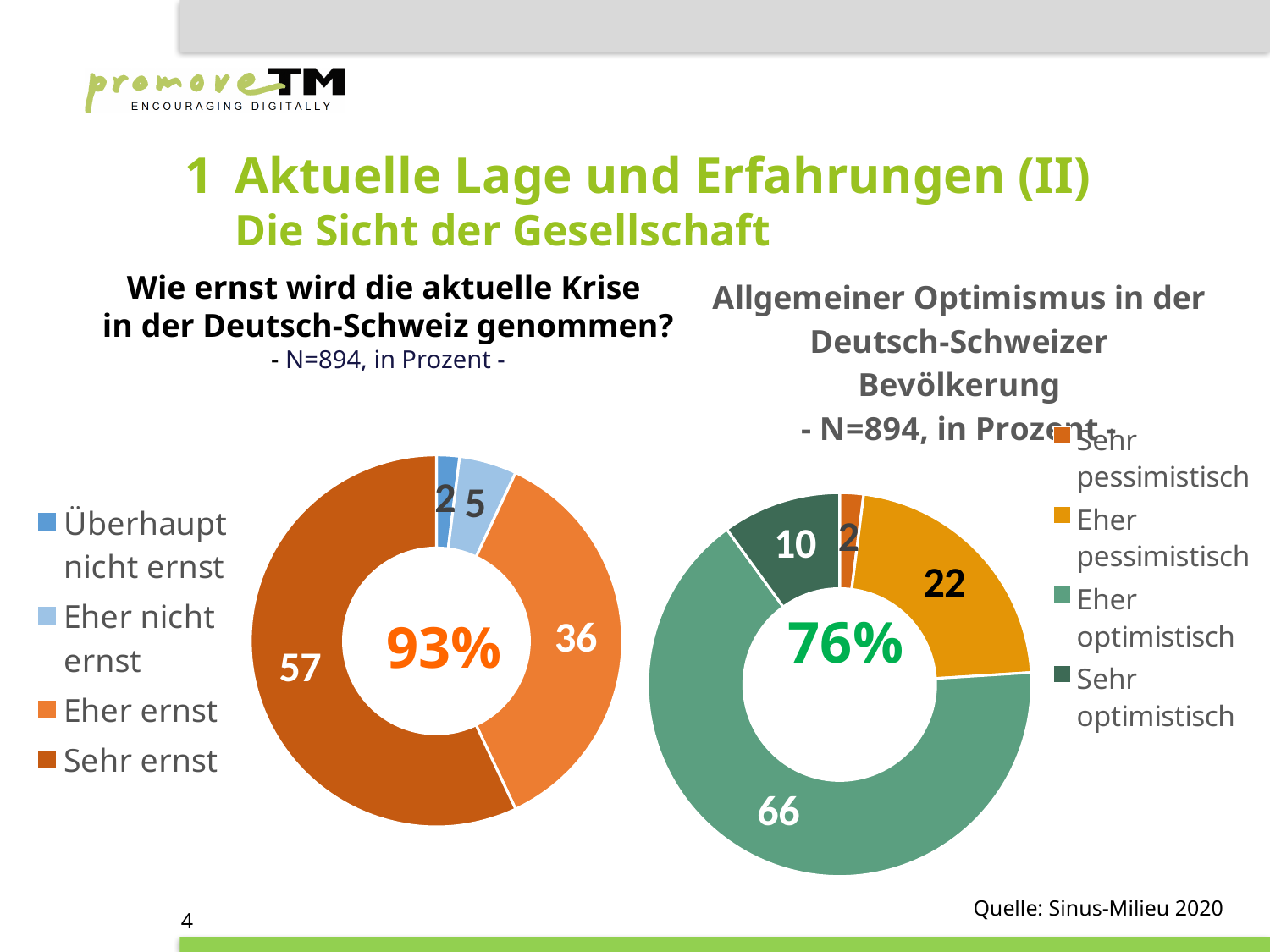
In the left chart (Wie ernst wird die aktuelle Krise in der Deutsch-Schweiz genommen?), what is the difference between Sehr ernst and Eher ernst? 21 In the left chart (Wie ernst wird die aktuelle Krise in der Deutsch-Schweiz genommen?), which category has the smallest value? Überhaupt nicht ernst In the left chart (Wie ernst wird die aktuelle Krise in der Deutsch-Schweiz genommen?), what is the value for Sehr ernst? 57 In the right chart (Allgemeiner Optimismus in der Deutsch-Schweizer Bevölkerung), what is the value for Eher pessimistisch? 22 In the right chart (Allgemeiner Optimismus in der Deutsch-Schweizer Bevölkerung), which is larger: Sehr optimistisch or Eher pessimistisch? Eher pessimistisch In the left chart (Wie ernst wird die aktuelle Krise in der Deutsch-Schweiz genommen?), what is the value for Eher ernst? 36 In the right chart (Allgemeiner Optimismus in der Deutsch-Schweizer Bevölkerung), what is the value for Eher optimistisch? 66 What kind of chart is used for the two charts on the slide? Doughnut (pie) chart In the right chart (Allgemeiner Optimismus in der Deutsch-Schweizer Bevölkerung), what is the difference between Eher optimistisch and Sehr optimistisch? 56 In the right chart (Allgemeiner Optimismus in der Deutsch-Schweizer Bevölkerung), which category has the largest value? Eher optimistisch In the left chart (Wie ernst wird die aktuelle Krise in der Deutsch-Schweiz genommen?), how many categories does the legend list? 4 In the left chart (Wie ernst wird die aktuelle Krise in der Deutsch-Schweiz genommen?), what percentage is shown in the centre of the ring? 93%